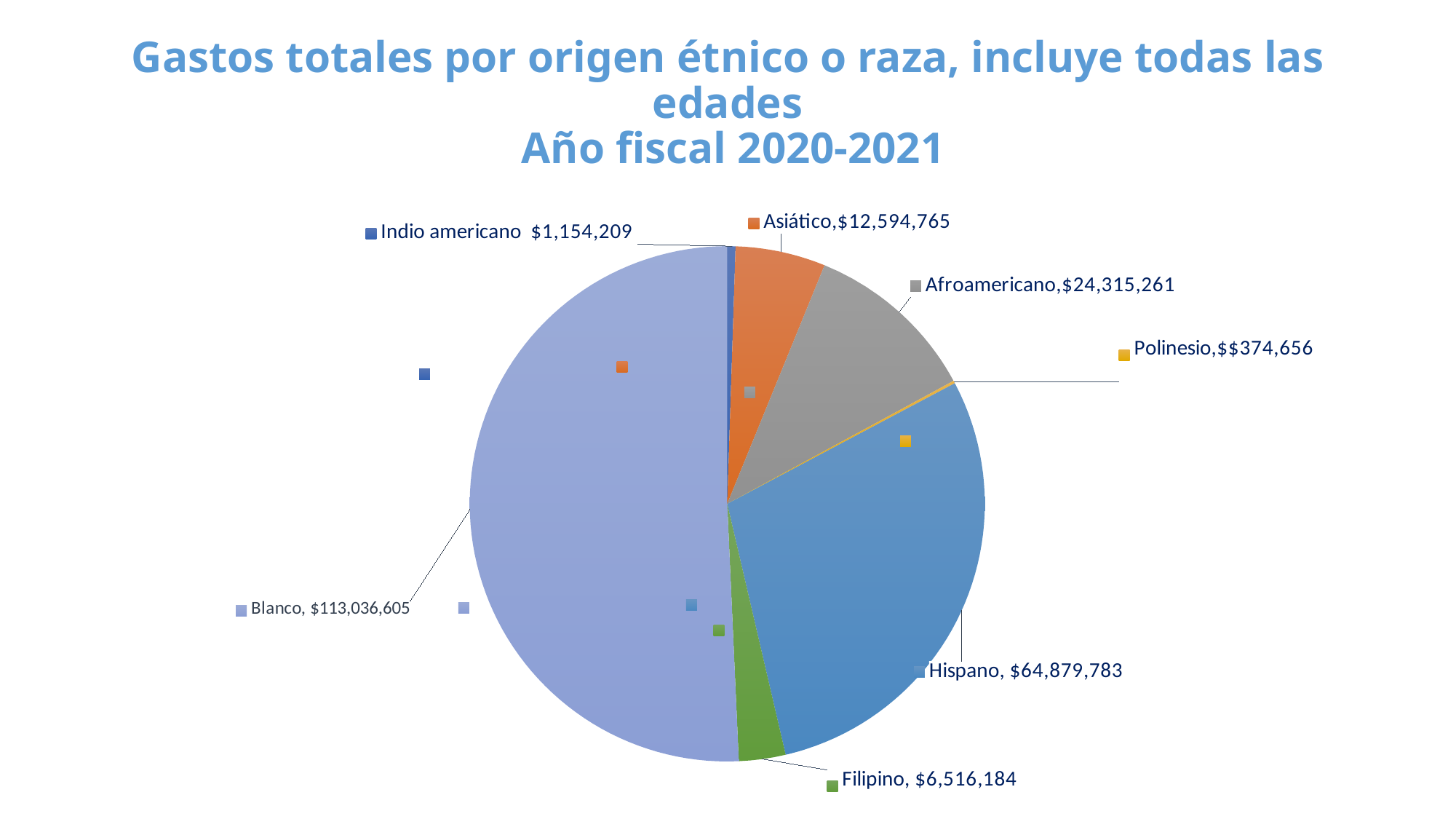
What kind of chart is shown on the slide? pie chart What is the value for Indio americano? $1,154,209 Which category has the lowest value? Polinesio How many categories does the pie chart show? 7 What is the value for Hispano? $64,879,783 What is the value for Afroamericano? $24,315,261 What is the value for Asiático? $12,594,765 Which is larger, the value for Afroamericano or the value for Asiático? Afroamericano What is the difference between the values for Blanco and Hispano? $48,156,822 What is the value for Blanco? $113,036,605 Which category has the highest value? Blanco What is the value for Filipino? $6,516,184